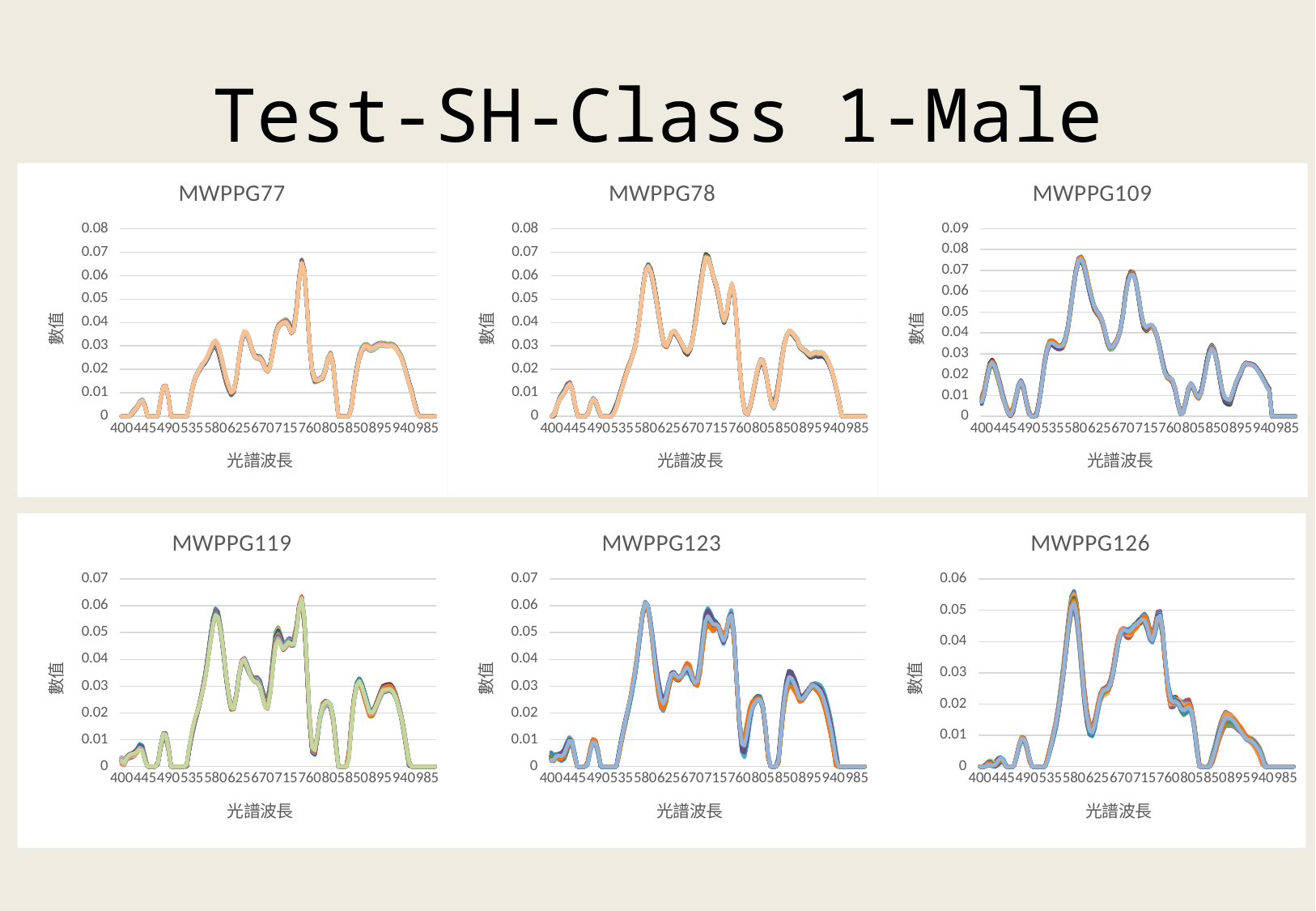
What kind of chart is MWPPG77? line chart In the MWPPG78 chart, which is larger, the value at 580 or the value at 850? 580 How many charts are shown on the slide? 6 In the MWPPG123 chart, is the value at 985 greater or less than 0.01? less In the MWPPG126 chart, is the peak value near 580 greater or less than 0.05? greater In the MWPPG78 chart, is the value at 580 greater or less than 0.06? greater What is the title of the chart in the top-right position? MWPPG109 How many wavelength labels are shown on the x axis of the MWPPG119 chart? 14